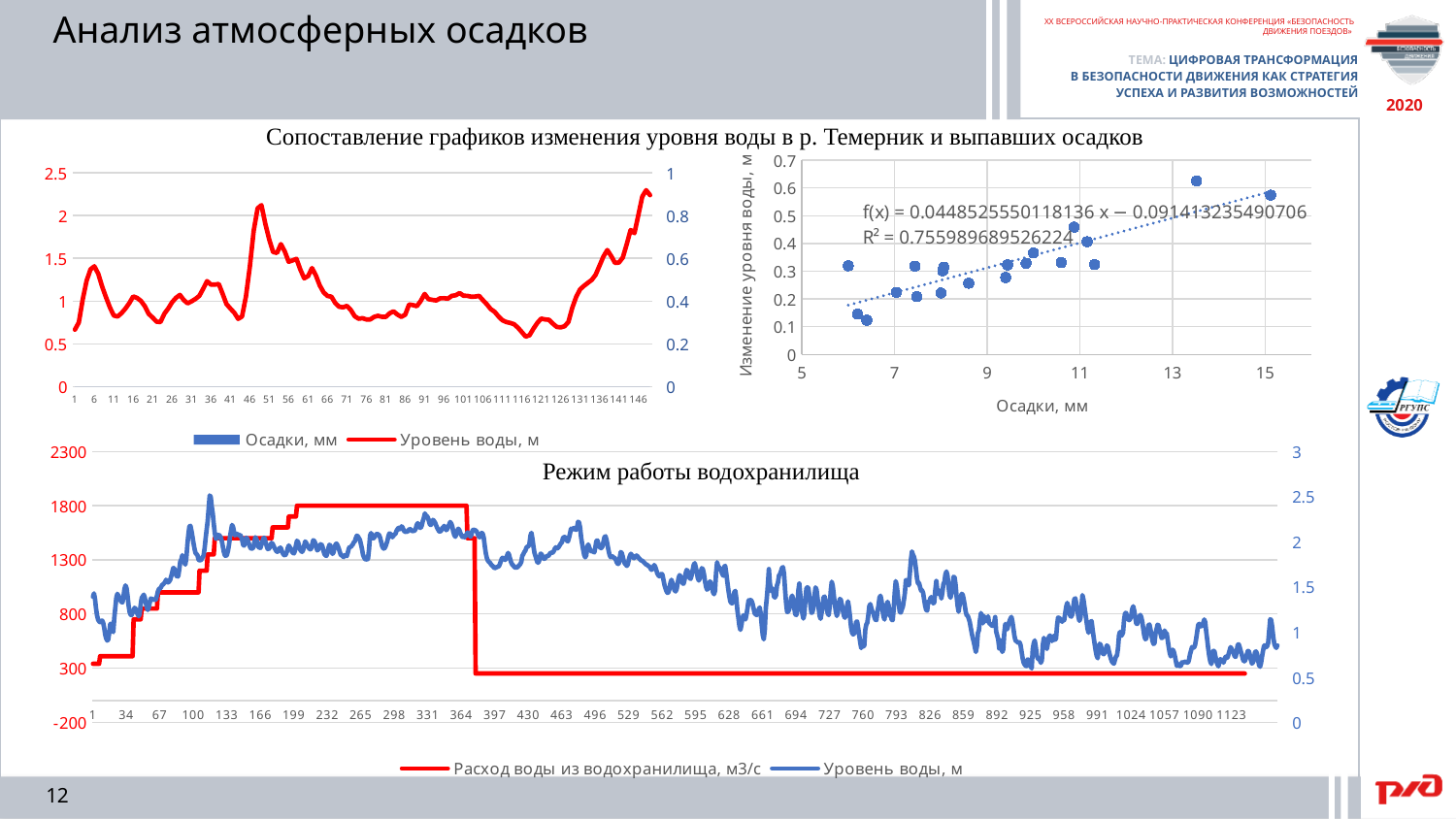
In the top-right scatter chart, is the highest point (near x = 13.5) greater or less than 0.6 on the vertical axis? greater In the top-left chart, is the peak value of the red 'Уровень воды, м' line near x = 46 greater or less than 2? greater What kind of chart is the top-right chart with the axes 'Осадки, мм' and 'Изменение уровня воды, м'? scatter chart How many series does the legend of the top-left chart list? 2 What kind of chart is the top-left chart titled 'Сопоставление графиков изменения уровня воды в р. Темерник и выпавших осадков'? line chart In the top-left chart, what are the two legend entries? Осадки, мм; Уровень воды, м How many series does the legend of the bottom chart 'Режим работы водохранилища' list? 2 In the top-right scatter chart, do the points generally rise or fall as 'Осадки, мм' increases? rise In the top-right scatter chart, what is the trendline equation printed on the chart? f(x) = 0.0448525550118136 x − 0.0914132235490706 In the top-left chart, is the value of the red 'Уровень воды, м' line near x = 121 greater or less than 1? less In the top-right scatter chart, what R² value is printed for the trendline? R² = 0.755989689526224